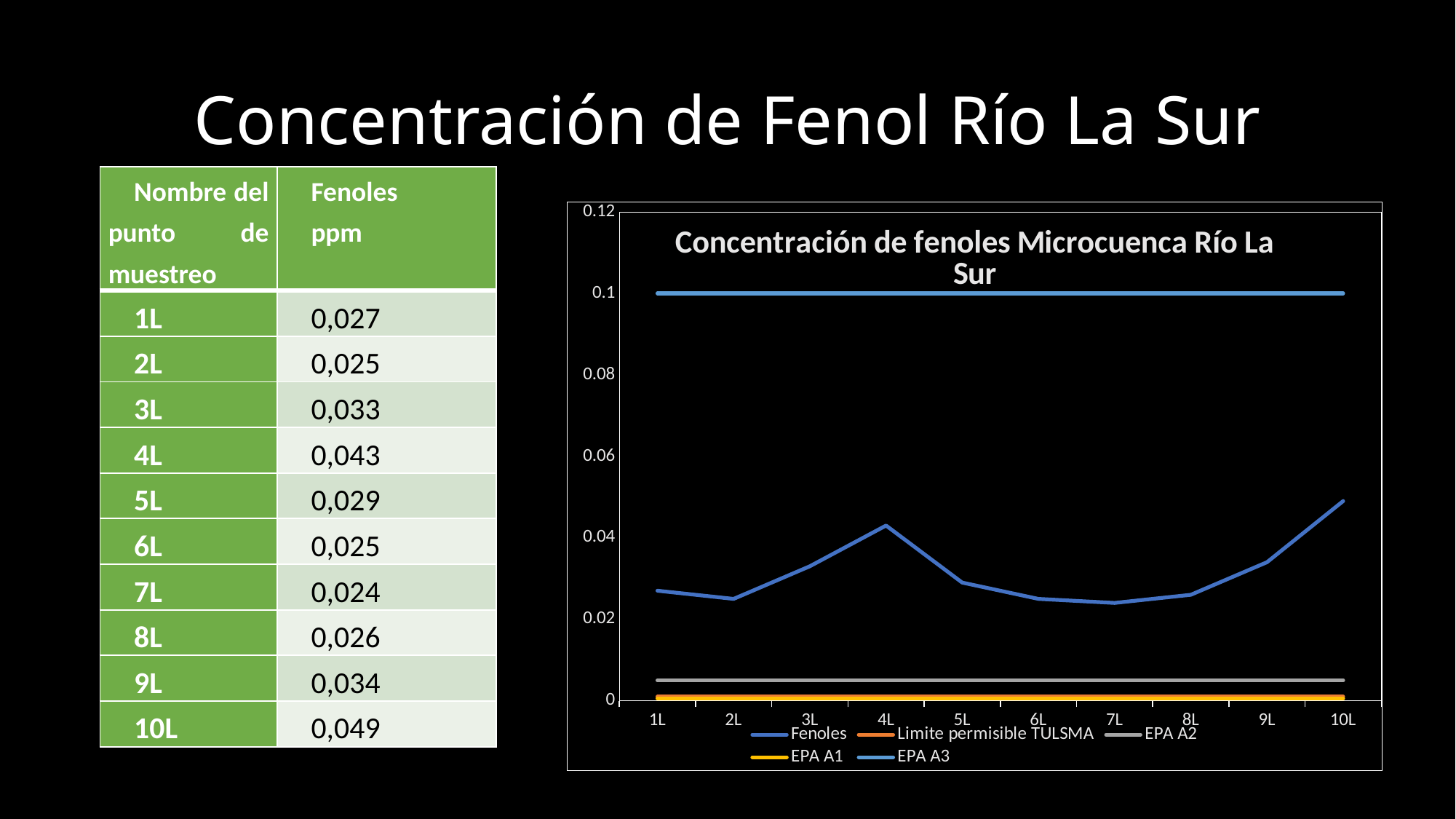
What kind of chart is shown on the slide? line chart What is the difference between the Fenoles values at 10L and 1L? 0,022 Does the Fenoles line rise or fall from 4L to 7L? fall How many sampling points are plotted along the x axis of the chart? 10 At what value does the EPA A3 line sit on the chart? 0.1 Is the Fenoles value at 7L greater or less than 0.04? less What is the title of the chart? Concentración de fenoles Microcuenca Río La Sur How many series does the legend of the chart list? 5 At which sampling point is the Fenoles line highest? 10L Which is larger, the Fenoles value at 4L or at 9L? 4L What is the Fenoles value in ppm at sampling point 10L? 0,049 Is the Fenoles value at 4L greater or less than 0.04? greater